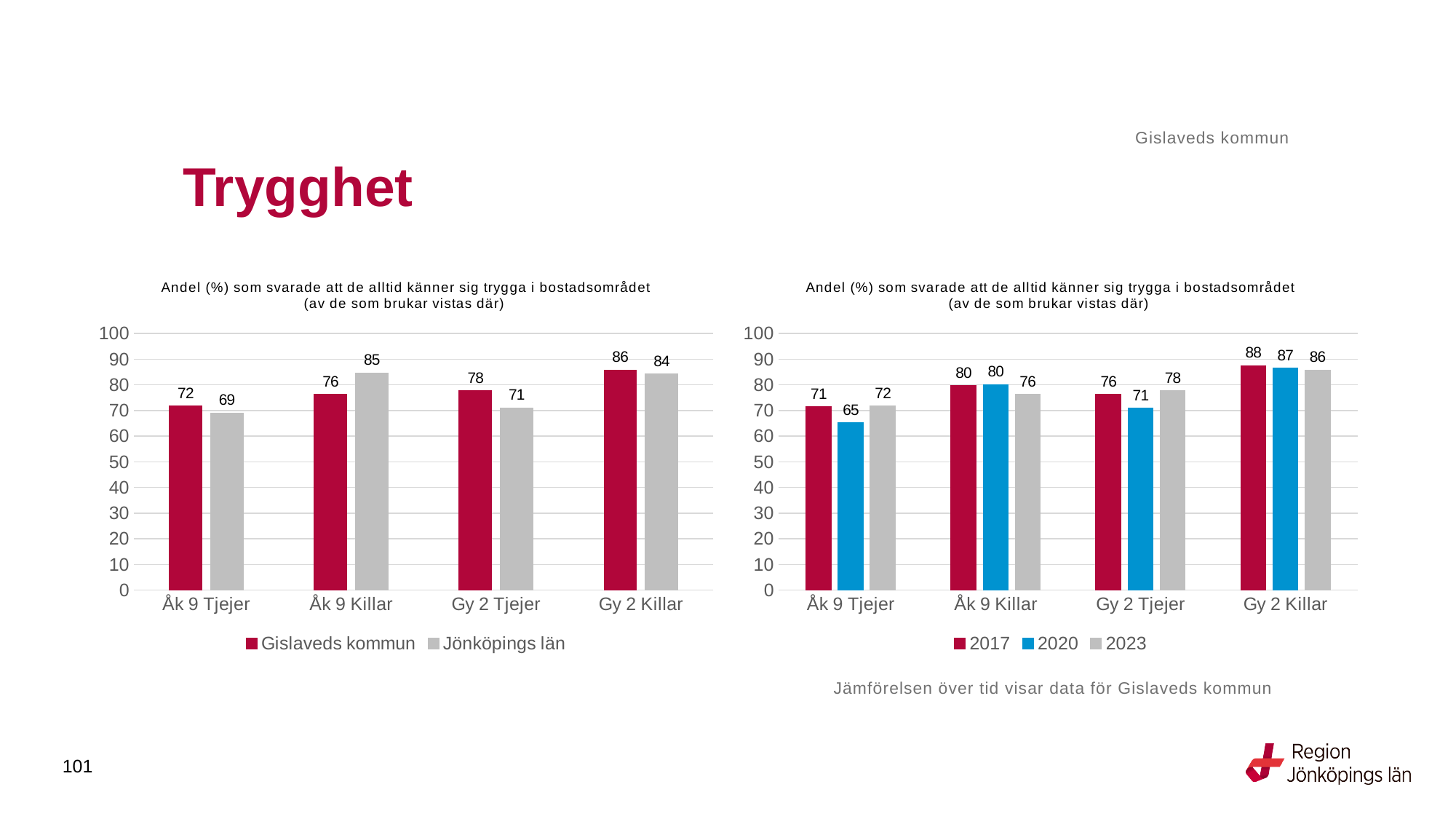
In the right chart, what is the difference between 2017 and 2020 for Gy 2 Tjejer? 5 In the right chart, what is the value for 2020 for Åk 9 Tjejer? 65 How many series does the legend of the right chart list? 3 In the right chart, what is the value for 2023 for Gy 2 Tjejer? 78 In the left chart, what is the difference between Gislaveds kommun and Jönköpings län for Gy 2 Tjejer? 7 What kind of chart is the left chart? Bar chart In the right chart, which category has the lowest value for 2020? Åk 9 Tjejer In the left chart, what is the value for Gislaveds kommun for Åk 9 Tjejer? 72 In the left chart, which category has the lowest value for Jönköpings län? Åk 9 Tjejer In the left chart, which is larger for Åk 9 Killar: Gislaveds kommun or Jönköpings län? Jönköpings län In the left chart, what is the value for Jönköpings län for Åk 9 Killar? 85 In the left chart, which category has the highest value for Gislaveds kommun? Gy 2 Killar